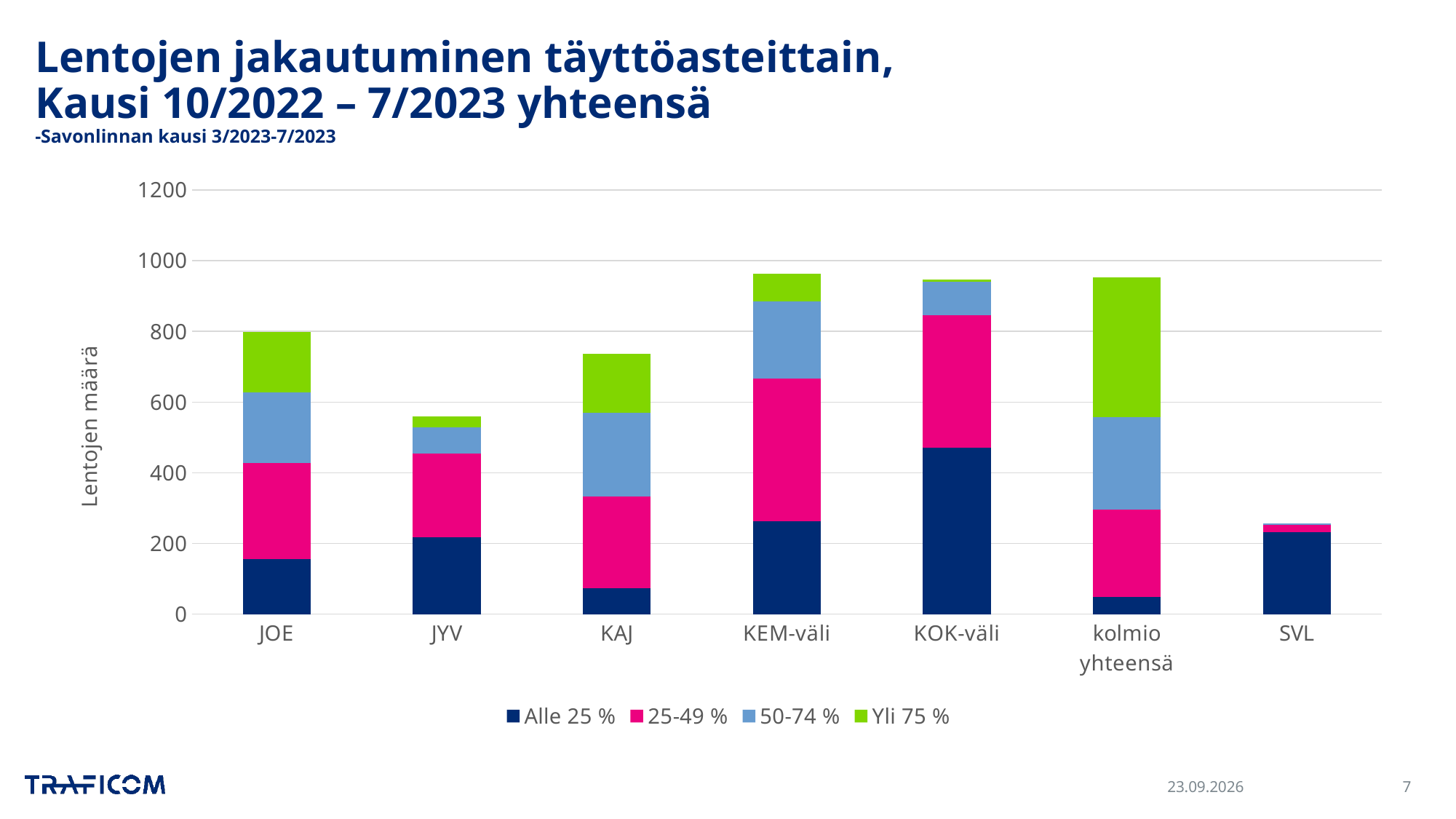
How many categories are shown on the x axis? 7 What kind of chart is shown on the slide? Stacked bar chart Is the total value for JOE greater or less than 600? greater Which category has the lowest total number of flights? SVL Which category has the largest 'Alle 25 %' segment? KOK-väli Which has a larger total number of flights, JOE or JYV? JOE How many series does the legend list? 4 Is the total value for JYV greater or less than 600? less Which colour represents the '25-49 %' series in the legend? Pink What is the label of the y axis? Lentojen määrä Is the 'Alle 25 %' value for KOK-väli greater or less than 400? greater Which category has the largest 'Yli 75 %' segment? kolmio yhteensä